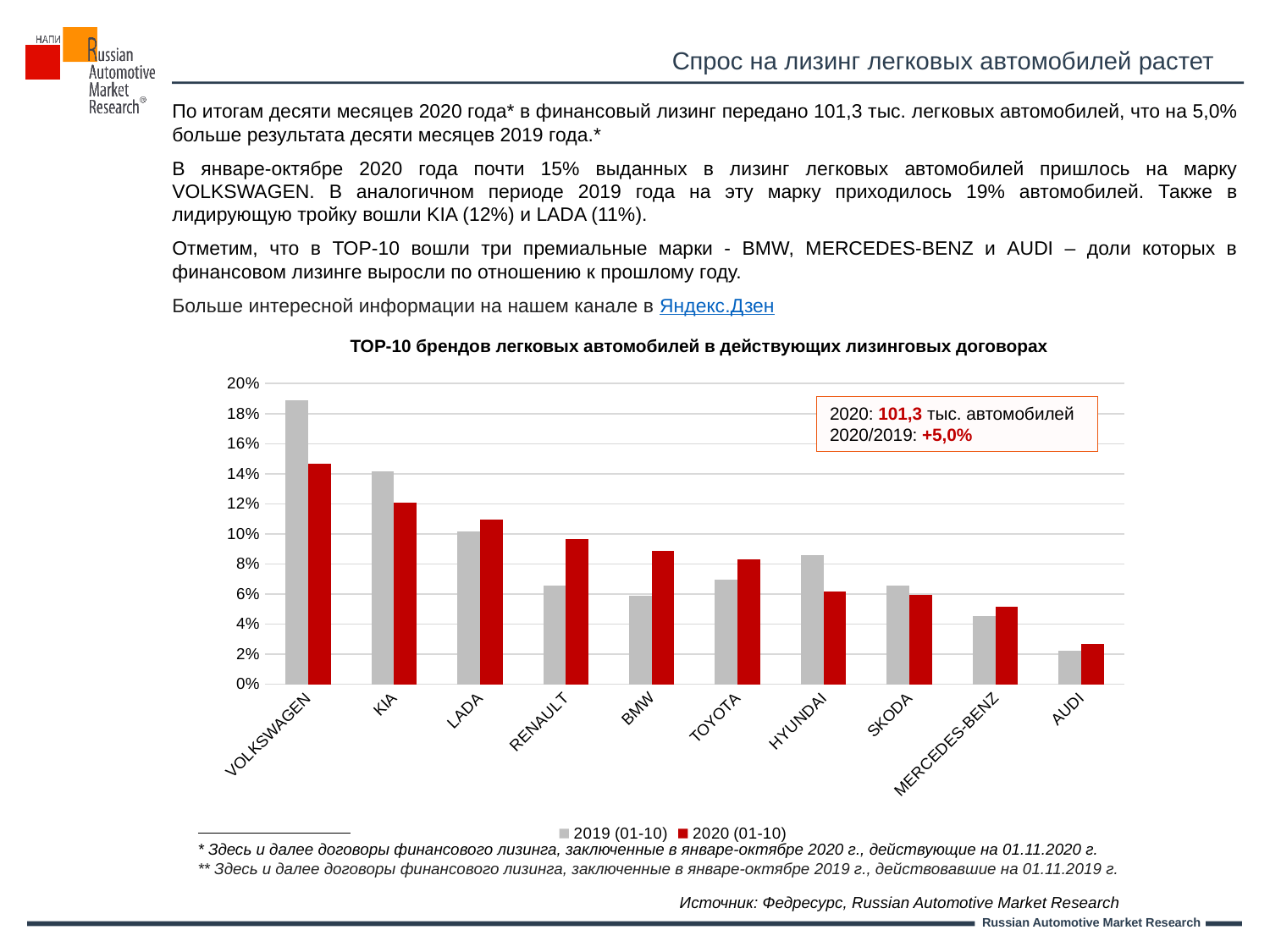
Which brand has the highest value in the 2020 (01-10) series? VOLKSWAGEN Do the 2020 (01-10) values rise or fall moving from VOLKSWAGEN to AUDI along the x axis? fall Is the 2020 (01-10) value for AUDI greater or less than 4%? less How many brands are shown on the x axis of the chart? 10 What colour are the bars for the 2020 (01-10) series? red Is the 2019 (01-10) value for VOLKSWAGEN greater or less than 16%? greater Which brand has the highest value in the 2019 (01-10) series? VOLKSWAGEN What kind of chart is shown on the slide? bar chart Which brand has the lowest value in the 2020 (01-10) series? AUDI For RENAULT, which series has the larger value, 2019 (01-10) or 2020 (01-10)? 2020 (01-10) For HYUNDAI, which series has the larger value, 2019 (01-10) or 2020 (01-10)? 2019 (01-10) How many series does the chart legend list? 2